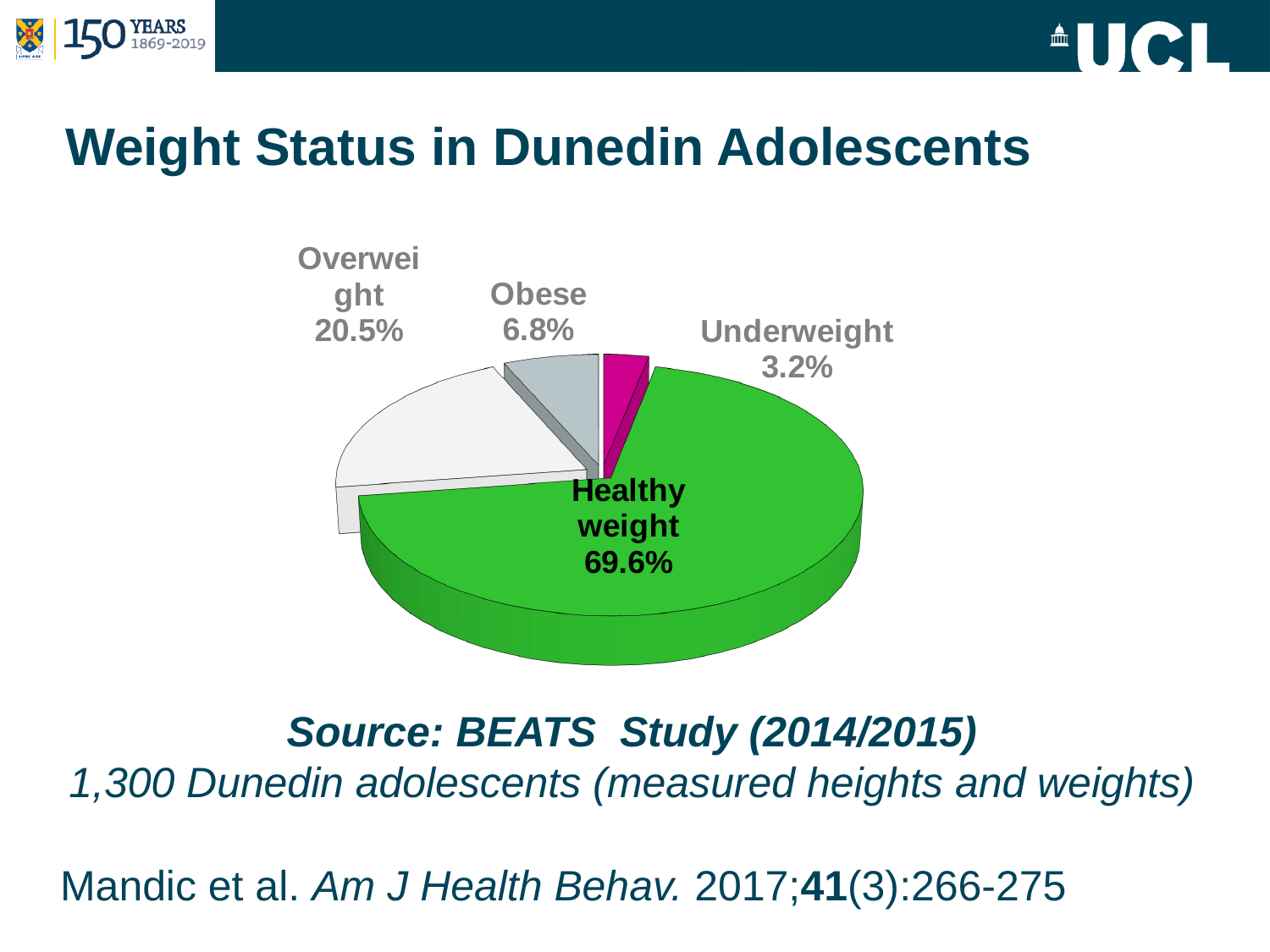
What percentage of Dunedin adolescents are underweight? 3.2% How many weight status categories are shown in the pie chart? 4 What colour is the Healthy weight slice of the pie chart? Green What percentage of Dunedin adolescents are overweight? 20.5% Which weight status category has the smallest share of the pie? Underweight Which is larger, the Obese slice or the Underweight slice? Obese Which weight status category has the largest share of the pie? Healthy weight What is the difference in percentage points between the Overweight and Obese slices? 13.7 What percentage of Dunedin adolescents are at a healthy weight according to the pie chart? 69.6% What type of chart is shown on the slide? Pie chart What is the title of the slide containing the chart? Weight Status in Dunedin Adolescents What percentage of Dunedin adolescents are obese? 6.8%